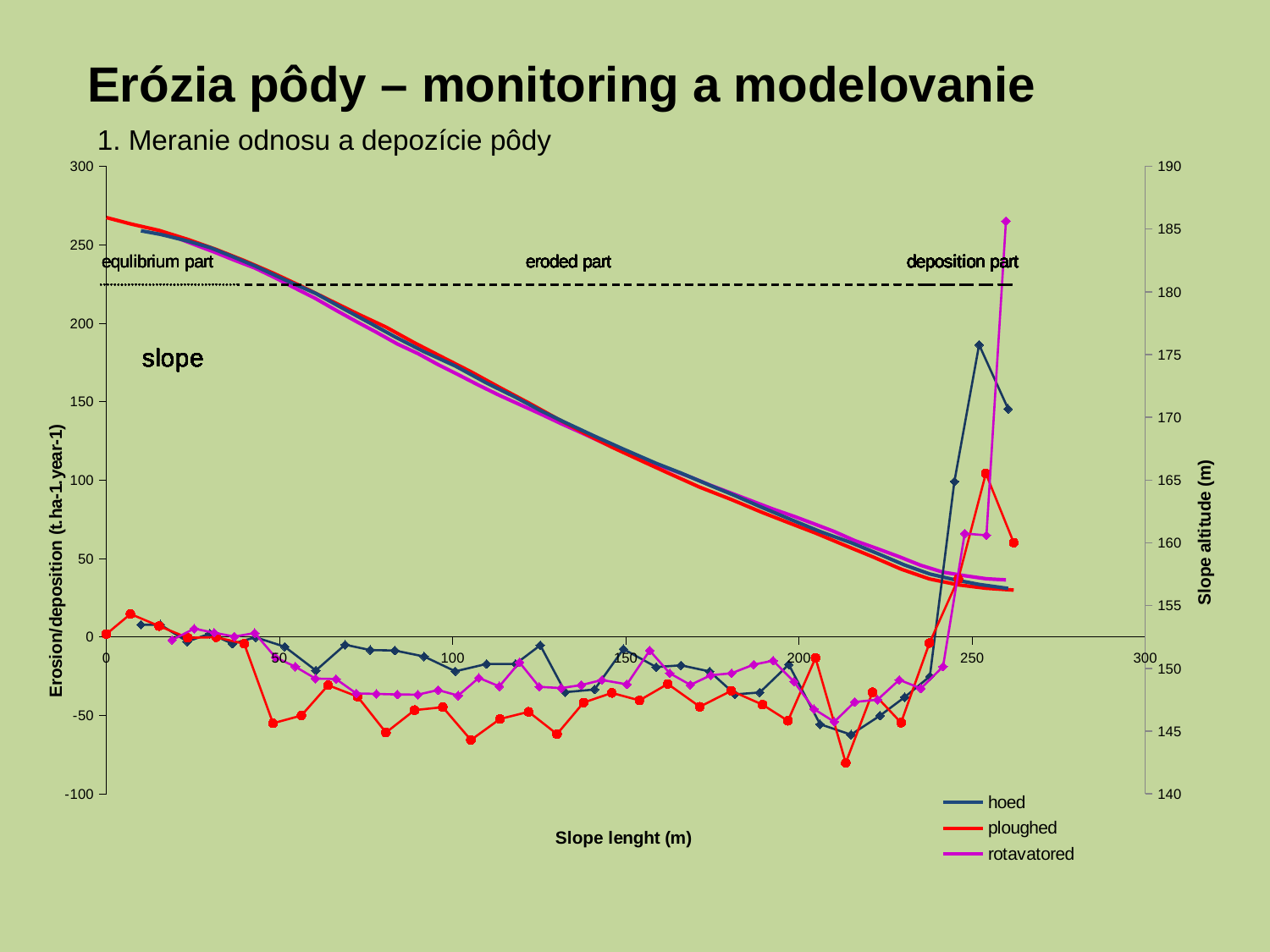
Is the lowest value of the ploughed erosion/deposition series greater or less than -50 t.ha-1.year-1? less Is the peak value of the rotavatored erosion/deposition series greater or less than 250 t.ha-1.year-1? greater Is the peak value of the hoed erosion/deposition series greater or less than 150 t.ha-1.year-1? greater What is the title of the x axis? Slope lenght (m) Which series reaches the highest erosion/deposition value in the deposition part of the slope? rotavatored Does the slope altitude rise or fall as slope length increases from 0 to 250 m? fall How many series does the legend list? 3 What are the three series named in the legend? hoed, ploughed, rotavatored Which series reaches the lowest erosion/deposition value along the slope? ploughed What kind of chart is shown on the slide? line chart